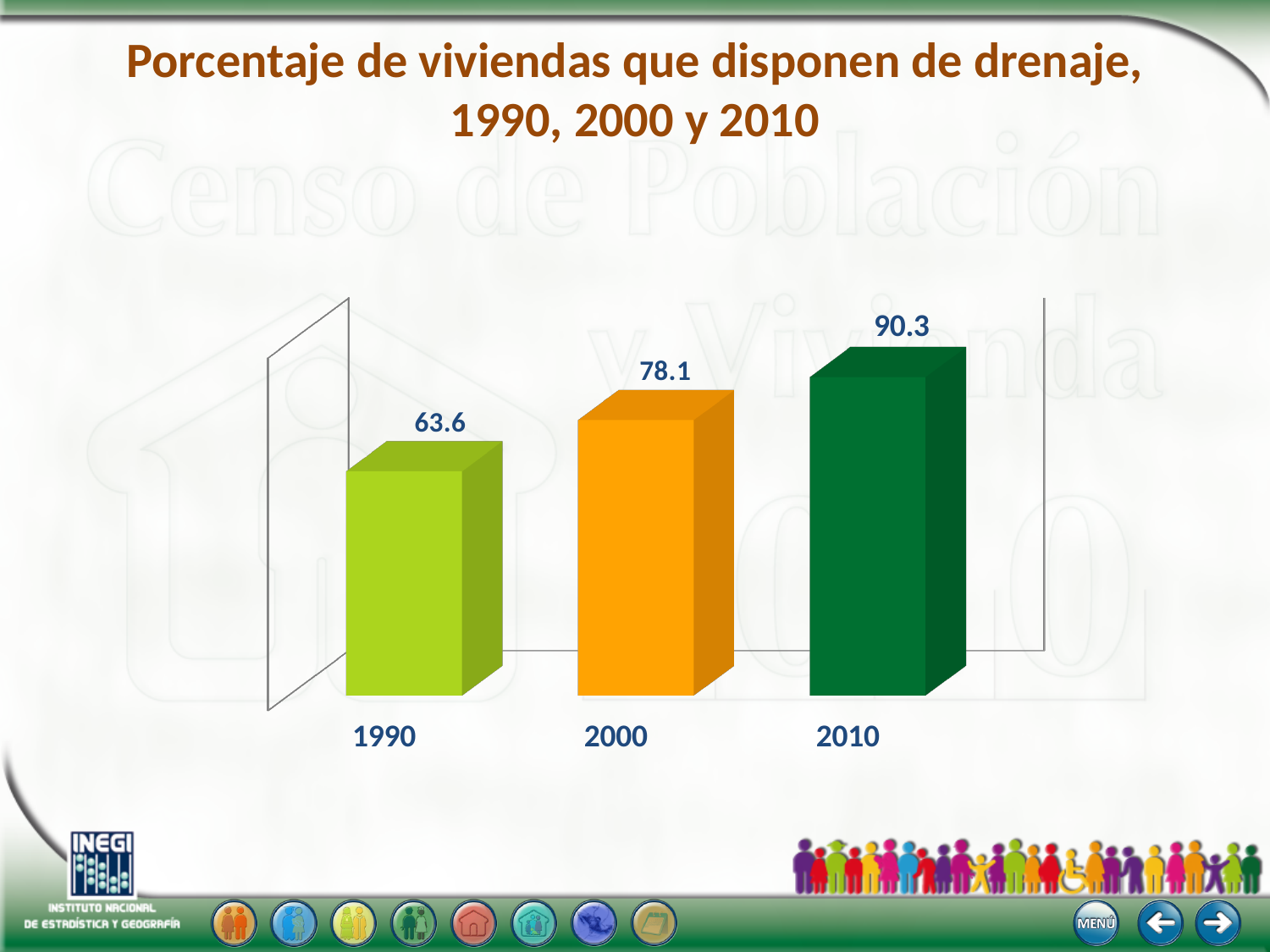
What is the value for 1990? 63.6 Do the values rise or fall from 1990 to 2010? rise Which year has the lowest value? 1990 What kind of chart is shown on the slide? bar chart What is the value for 2010? 90.3 Which is larger, the value for 2000 or the value for 2010? 2010 What is the title of the chart? Porcentaje de viviendas que disponen de drenaje, 1990, 2000 y 2010 What is the value for 2000? 78.1 What is the difference between the values for 2000 and 1990? 14.5 How many years are shown on the chart? 3 What is the difference between the values for 2010 and 1990? 26.7 Which year has the highest value? 2010